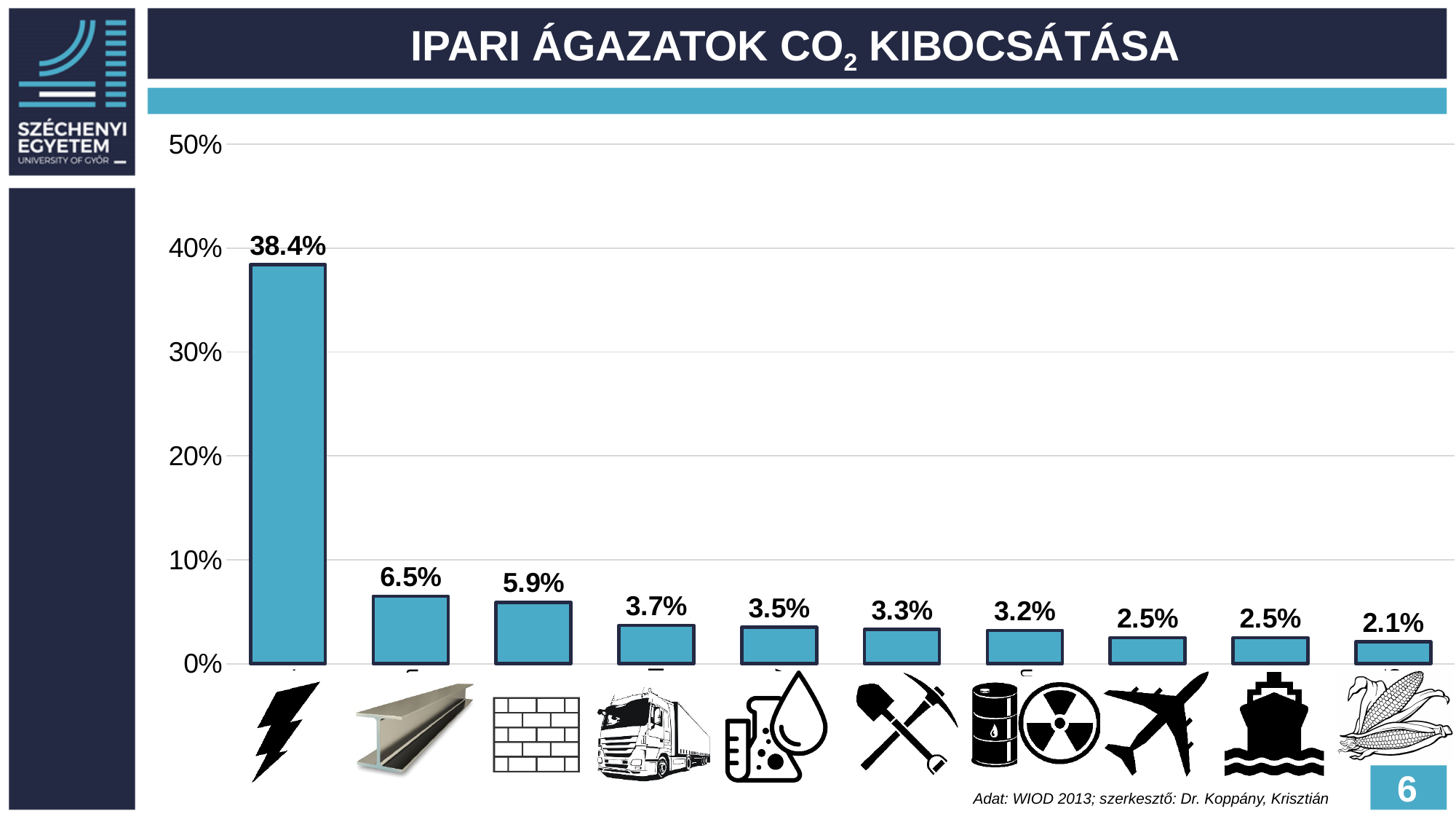
What is the difference between the leftmost bar (38.4%) and the second bar (6.5%)? 31.9 percentage points Which bar has the lowest value, and what is it? The rightmost bar (corn icon), 2.1% What is the title of the chart on the slide? IPARI ÁGAZATOK CO2 KIBOCSÁTÁSA What is the value of the bar above the truck icon? 3.7% Which is larger: the bar above the brick wall icon or the bar above the truck icon? The bar above the brick wall icon (5.9%) What is the value of the bar above the brick wall icon? 5.9% How many bars are shown in the chart? 10 What is the value of the second bar from the left (above the steel beam icon)? 6.5% What is the value of the bar above the corn icon (rightmost bar)? 2.1% What is the value of the tallest bar in the chart? 38.4% What is the value of the bar above the airplane icon? 2.5% What type of chart is shown on the slide? Bar chart